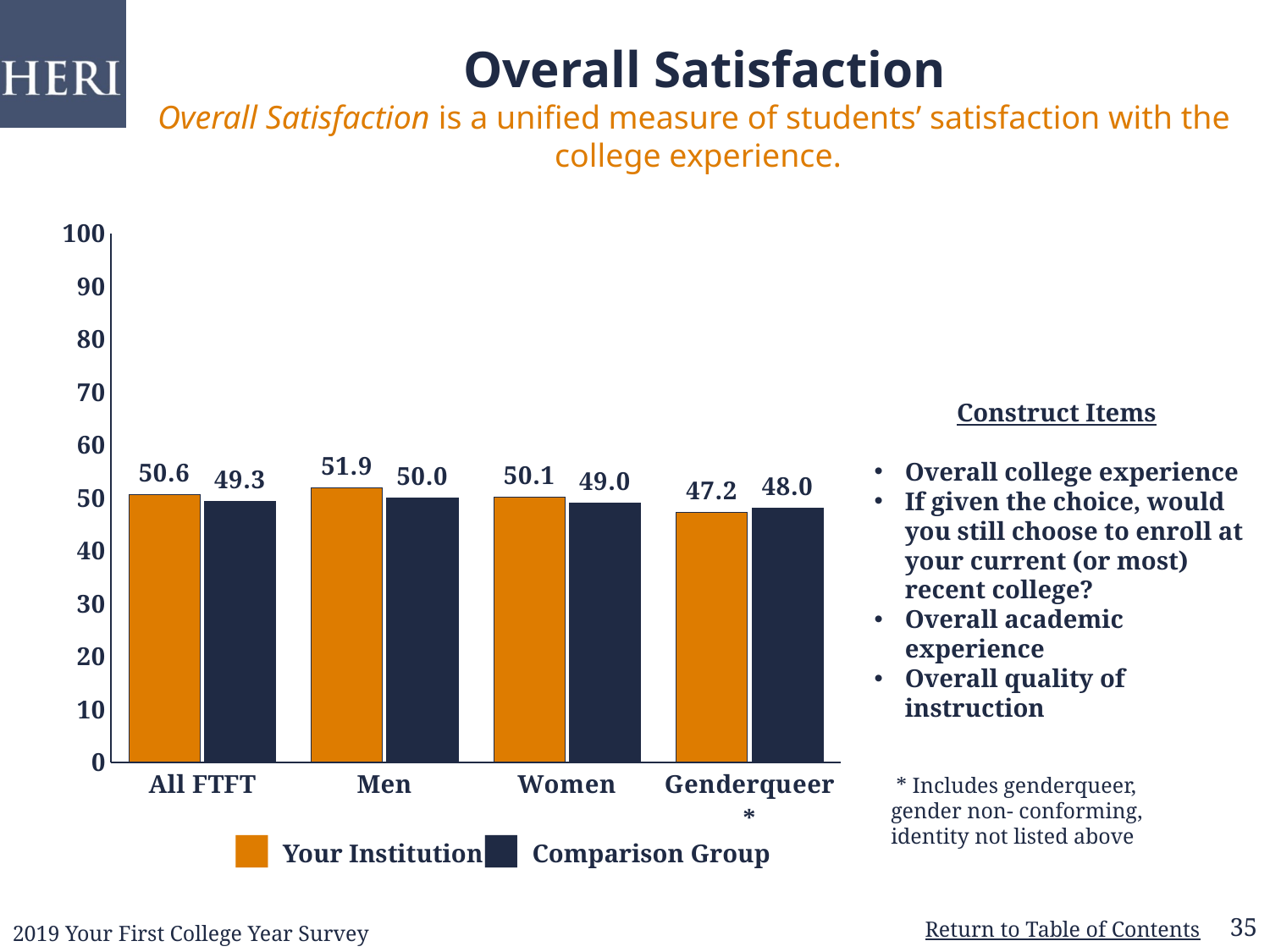
What is the Your Institution value for Genderqueer? 47.2 Is the Comparison Group value for Men greater or less than 60? less What is the Your Institution value for All FTFT? 50.6 Which category has the highest Your Institution value? Men What is the Comparison Group value for Women? 49.0 Which colour represents Your Institution in the legend? orange Which category has the lowest Comparison Group value? Genderqueer What is the difference between the Your Institution and Comparison Group values for Men? 1.9 How many categories are shown on the x axis? 4 What kind of chart is shown on the slide? bar chart How many series does the legend list? 2 For Genderqueer, which is larger: Your Institution or Comparison Group? Comparison Group